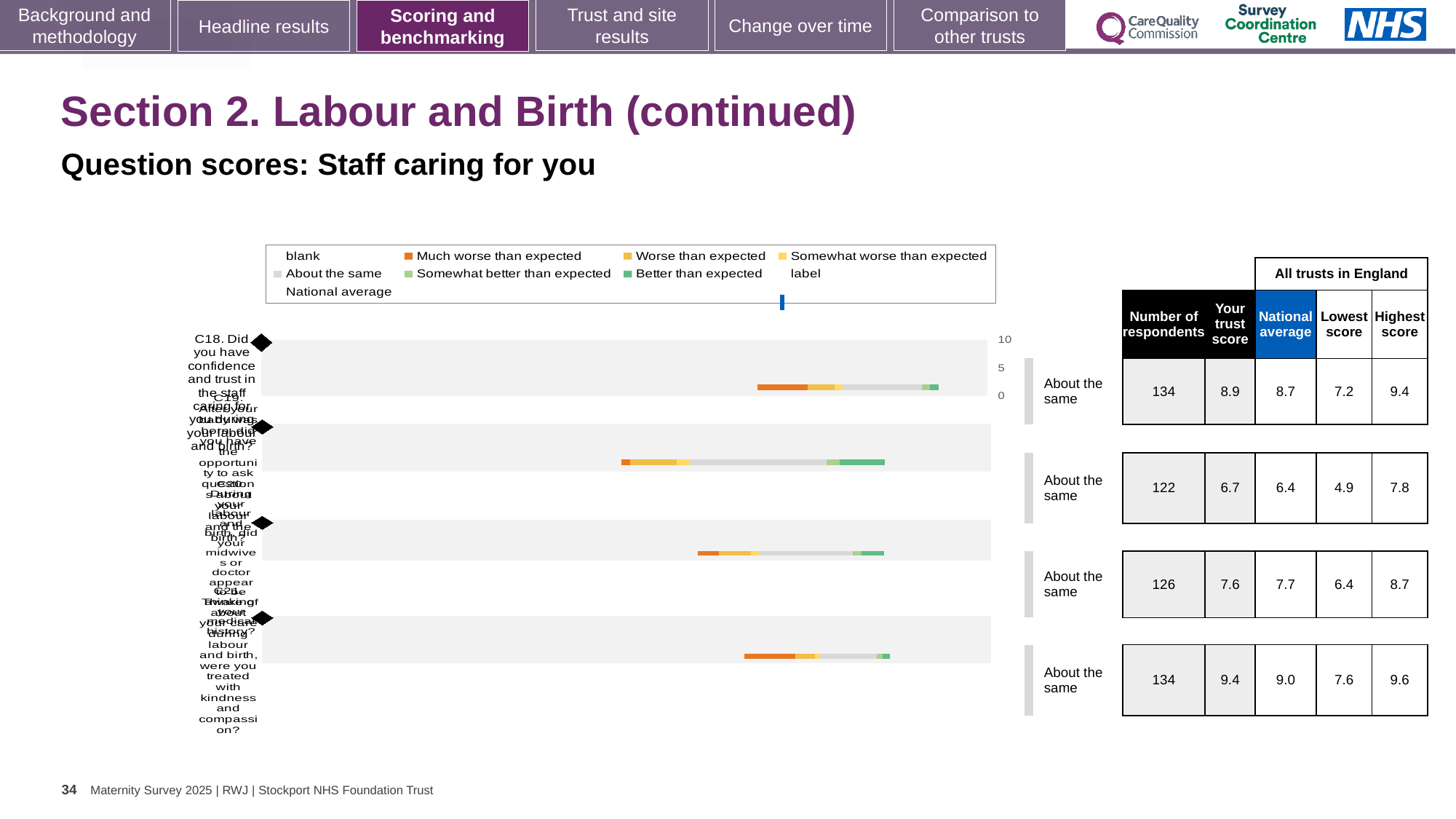
What kind of chart is shown on the slide? bar chart Which question has the lowest trust score? C19 What is the difference between the trust score and the national average for question C18? 0.2 What is the number of respondents for question C18 in the table beside the chart? 134 What is the national average for question C20 (the third row)? 7.7 What is the highest score across all trusts in England for question C21 (the fourth row)? 9.6 Which question has the highest trust score? C21 What is the lowest score across all trusts in England for question C19 (the second row)? 4.9 What benchmark category is shown for question C21 (the fourth row)? About the same What is the trust score for question C19 (the second row)? 6.7 For question C20, which is larger: the trust score or the national average? National average How many questions (bars) are plotted in the chart? 4